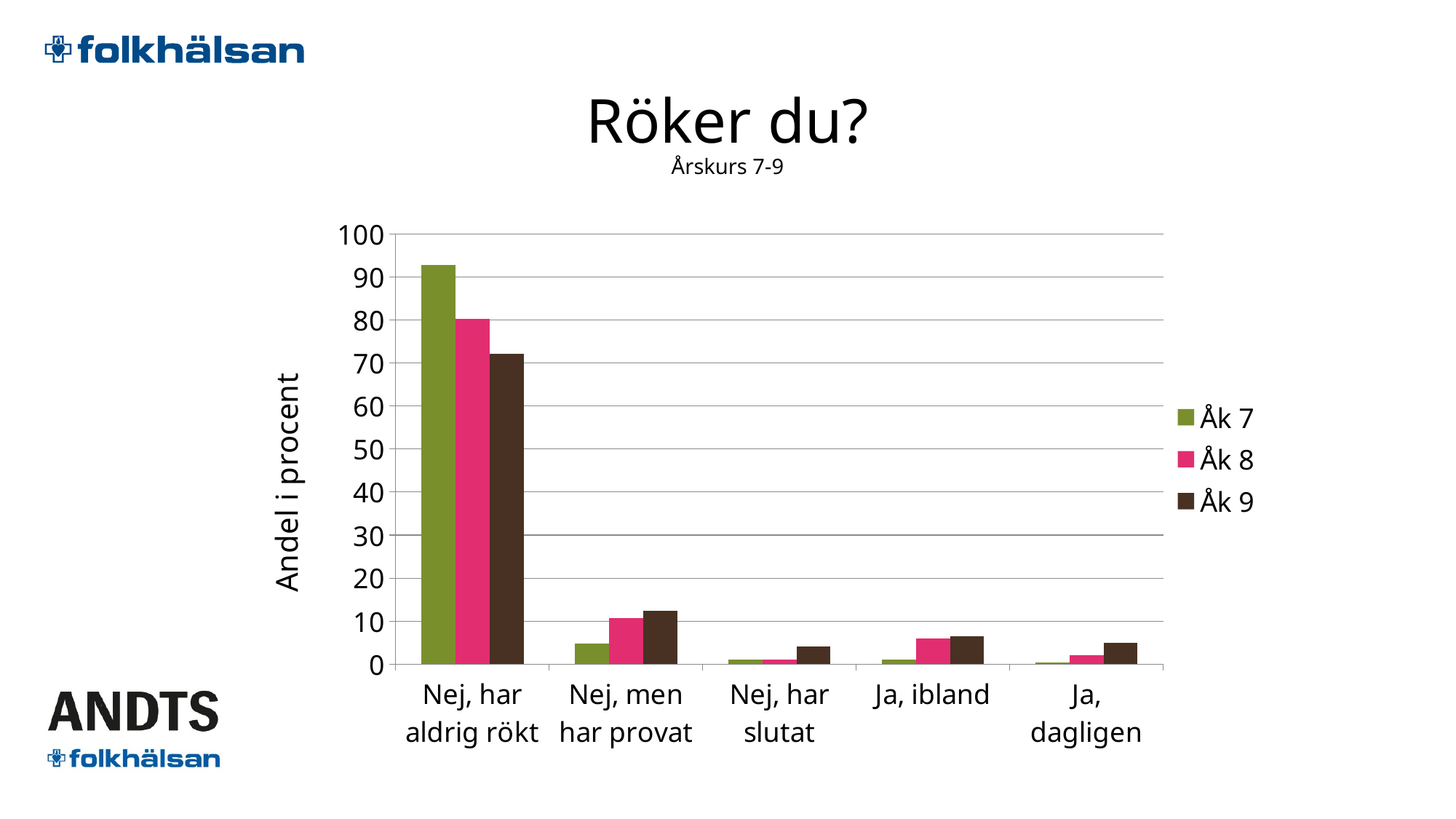
How many response categories are shown on the x axis? 5 Is the value for Åk 7 in "Nej, men har provat" greater or less than 10? less For Åk 7, which category has the highest value? Nej, har aldrig rökt What kind of chart is shown on the slide? bar chart Is the value for Åk 7 in "Nej, har aldrig rökt" greater or less than 90? greater Which series has the lowest bar for "Nej, har aldrig rökt"? Åk 9 Is the value for Åk 9 in "Nej, men har provat" greater or less than 10? greater How many series does the legend list? 3 What is the label of the y axis? Andel i procent Which series has the highest bar for "Nej, har aldrig rökt"? Åk 7 For "Nej, har aldrig rökt", which is larger: Åk 8 or Åk 9? Åk 8